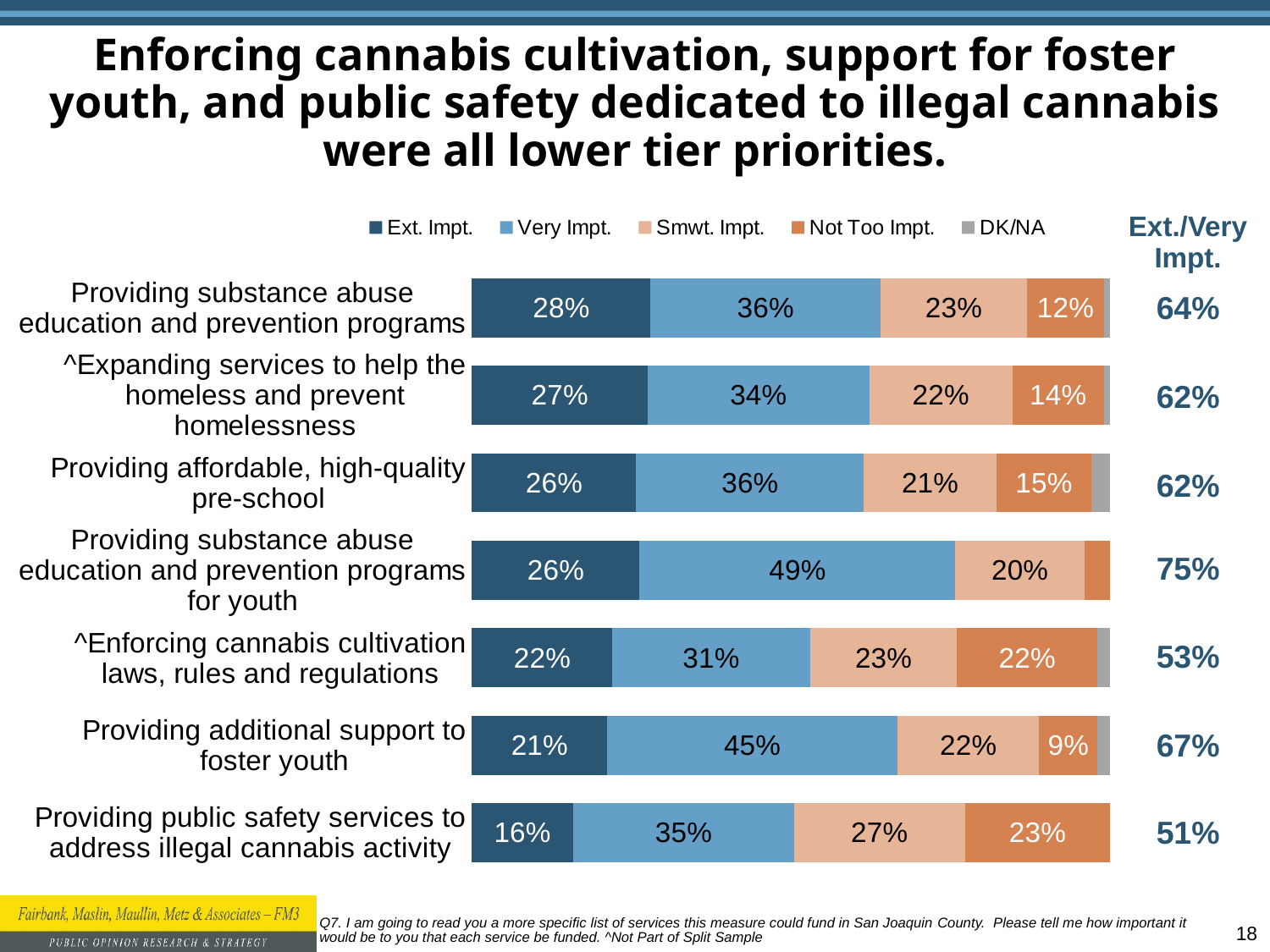
What is the combined Ext./Very Impt. figure shown for 'Providing substance abuse education and prevention programs for youth'? 75% How many series does the legend list? 5 What is the Ext. Impt. value for 'Providing public safety services to address illegal cannabis activity'? 16% What type of chart is shown on the slide? Stacked bar chart Which category has the lowest Ext. Impt. value? Providing public safety services to address illegal cannabis activity What is the difference in Ext. Impt. values between 'Providing substance abuse education and prevention programs' and 'Providing public safety services to address illegal cannabis activity'? 12 percentage points How many categories (bars) are shown in the chart? 7 Which category has the lowest Ext./Very Impt. combined figure? Providing public safety services to address illegal cannabis activity What percentage of respondents rated 'Providing additional support to foster youth' as Very Impt.? 45% Which category has the highest Very Impt. value? Providing substance abuse education and prevention programs for youth Which has a larger Not Too Impt. value: 'Providing affordable, high-quality pre-school' or 'Providing additional support to foster youth'? Providing affordable, high-quality pre-school What is the Not Too Impt. value for 'Enforcing cannabis cultivation laws, rules and regulations'? 22%